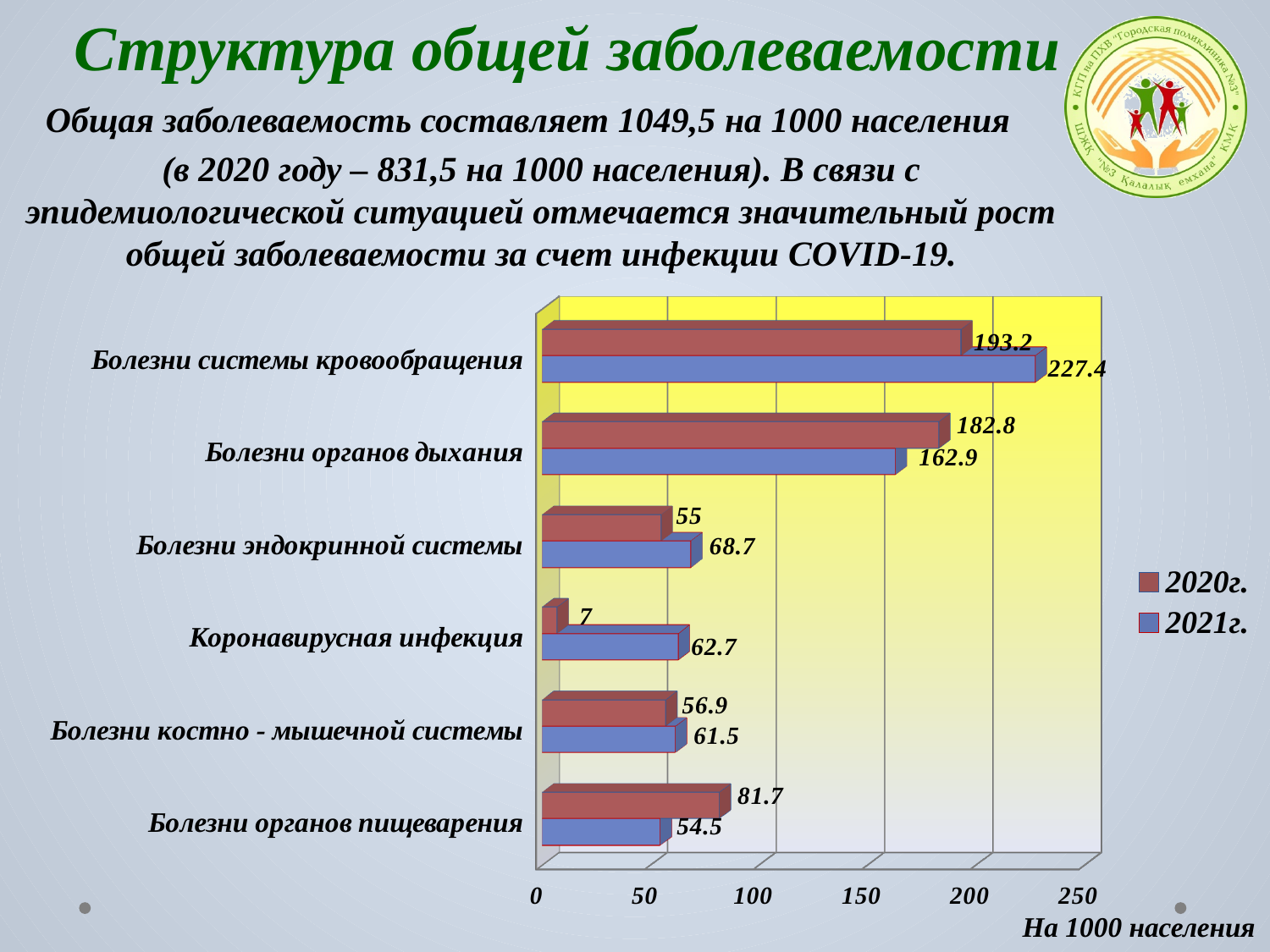
How many categories are shown on the chart? 6 Which category has the highest 2021г. value? Болезни системы кровообращения For Болезни органов дыхания, which year has the larger value, 2020г. or 2021г.? 2020г. What is the 2020г. value for Болезни эндокринной системы? 55 Which category has the lowest 2020г. value? Коронавирусная инфекция What is the 2020г. value for Коронавирусная инфекция? 7 What kind of chart is shown on the slide? Bar chart How many series does the legend list? 2 What is the difference between the 2021г. and 2020г. values for Коронавирусная инфекция? 55.7 What unit label is shown below the x axis of the chart? На 1000 населения What is the 2021г. value for Болезни органов пищеварения? 54.5 What is the 2021г. value for Болезни системы кровообращения? 227.4